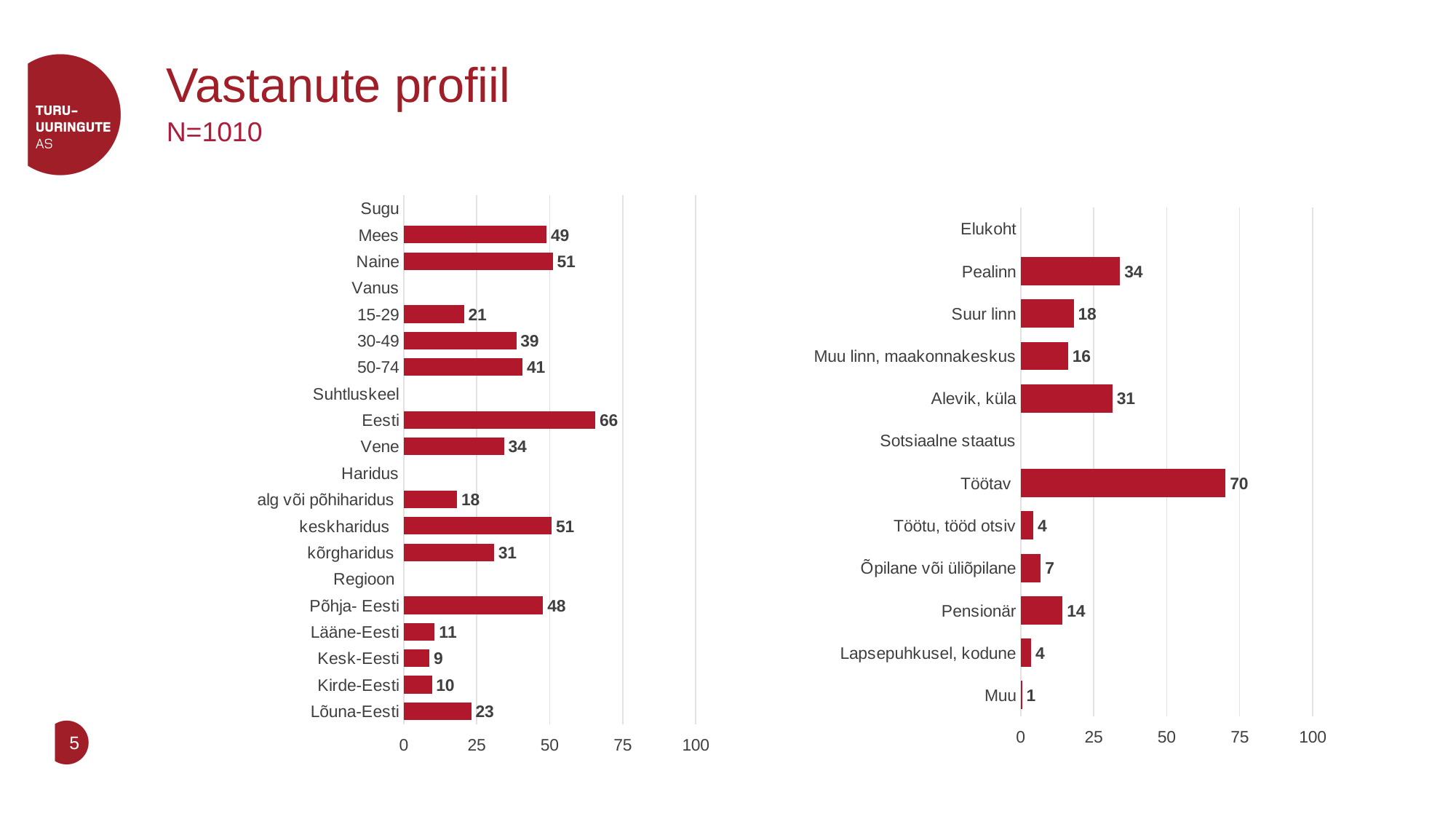
In the right chart, what is the value for Pensionär? 14 In the right chart, which category has the highest value? Töötav In the left chart, what is the value for Eesti? 66 In the left chart, which is larger, the value for 30-49 or the value for 50-74? 50-74 In the right chart, which category has the lowest value? Muu What type of chart is shown on the right side of the slide? bar chart In the right chart, is the value for Töötav greater or less than 50? greater In the right chart, what is the difference between the values for Pealinn and Suur linn? 16 In the left chart, what is the difference between the values for Eesti and Vene? 32 In the left chart, what is the value for Lõuna-Eesti? 23 What is the title of the slide? Vastanute profiil In the left chart, which of the Regioon categories has the lowest value? Kesk-Eesti